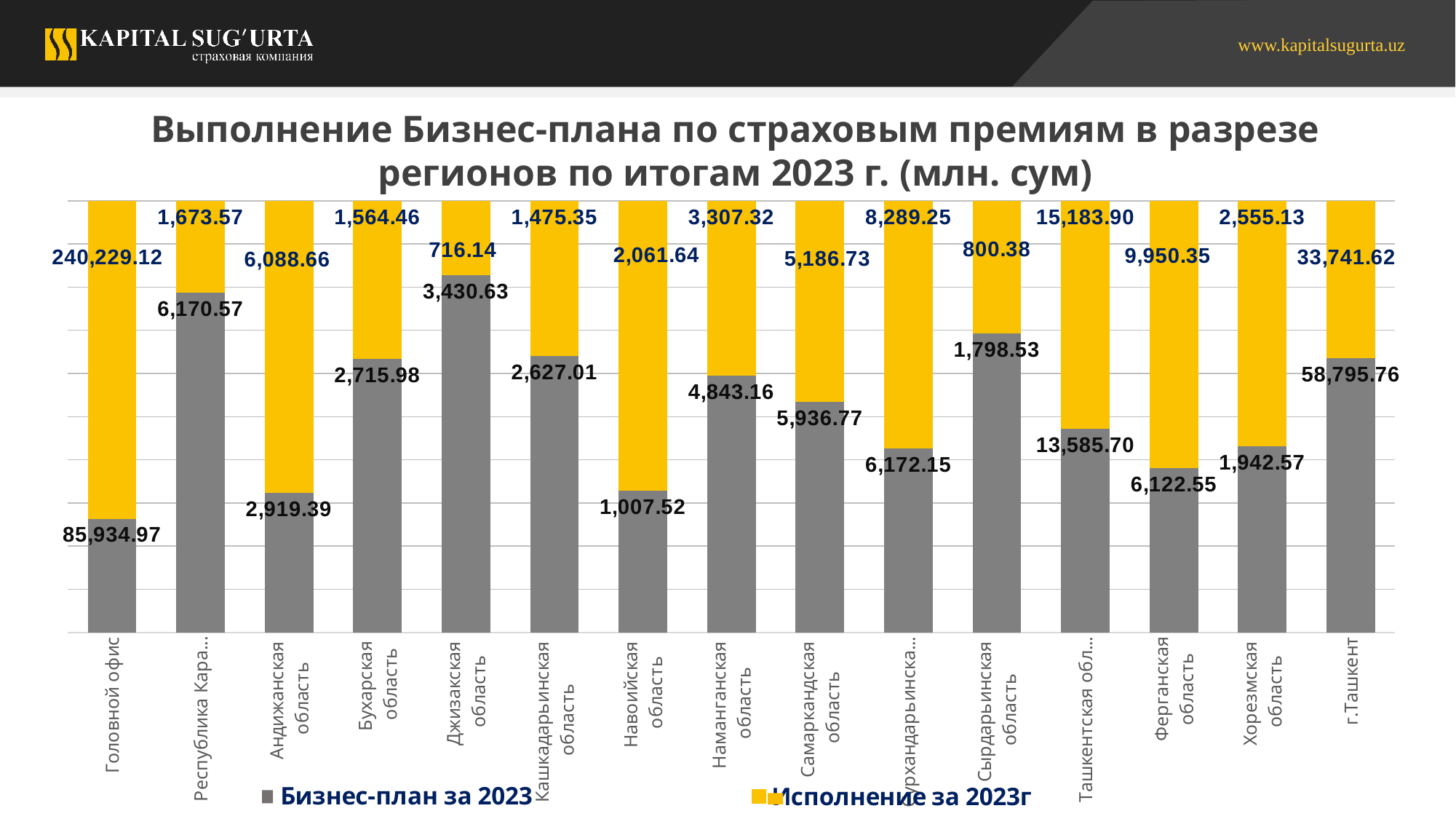
Which region has the lowest 'Бизнес-план за 2023' value? Навоийская область Which colour represents the 'Исполнение за 2023г' series? Yellow Which region has the lowest 'Исполнение за 2023г' value? Джизакская область What is the value of 'Бизнес-план за 2023' for Джизакская область? 3,430.63 How many regions (categories) are shown on the x axis? 15 What is the difference between 'Исполнение за 2023г' and 'Бизнес-план за 2023' for Ферганская область? 3,827.80 What is the value of 'Бизнес-план за 2023' for г.Ташкент? 58,795.76 What is the value of 'Исполнение за 2023г' for Головной офис? 240,229.12 Which region has the highest 'Исполнение за 2023г' value? Головной офис What type of chart is shown on the slide? Stacked bar chart How many series does the legend list? 2 For Самаркандская область, which is larger: 'Бизнес-план за 2023' or 'Исполнение за 2023г'? Бизнес-план за 2023